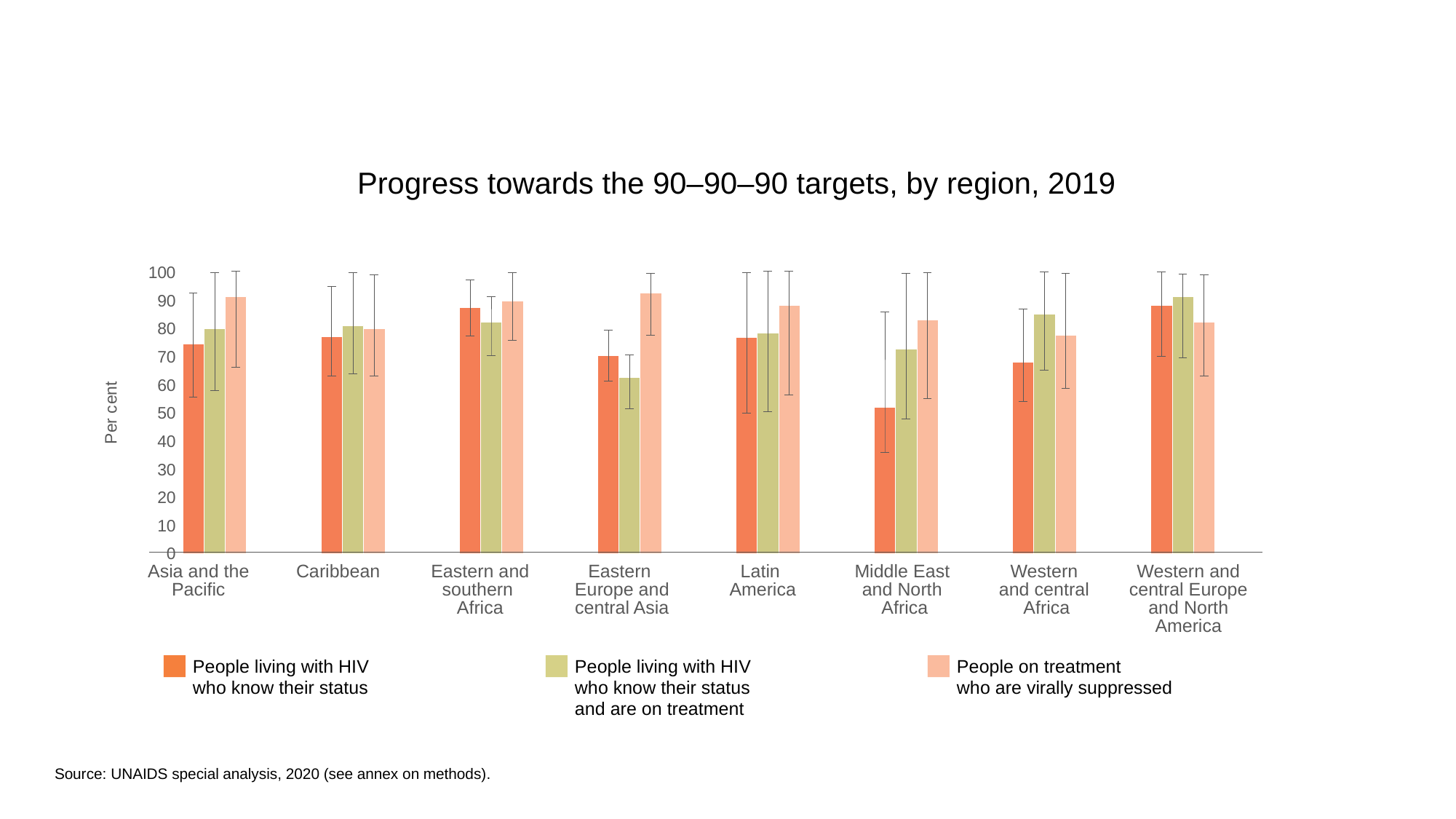
What kind of chart is shown on the slide? Bar chart In Western and central Africa, which is larger: the value for people living with HIV who know their status, or the value for people living with HIV who know their status and are on treatment? People living with HIV who know their status and are on treatment What is the label on the vertical axis? Per cent Which region has the highest value for people living with HIV who know their status and are on treatment? Western and central Europe and North America Is the value for people living with HIV who know their status and are on treatment in Eastern Europe and central Asia greater or less than 70? less How many series does the legend list? 3 Which region has the lowest value for people living with HIV who know their status and are on treatment? Eastern Europe and central Asia Is the value for people living with HIV who know their status in Middle East and North Africa greater or less than 60? less How many regions are shown on the x axis? 8 What is the title of the chart? Progress towards the 90–90–90 targets, by region, 2019 Which region has the lowest value for people living with HIV who know their status? Middle East and North Africa In Eastern Europe and central Asia, which is larger: the value for people on treatment who are virally suppressed, or the value for people living with HIV who know their status? People on treatment who are virally suppressed